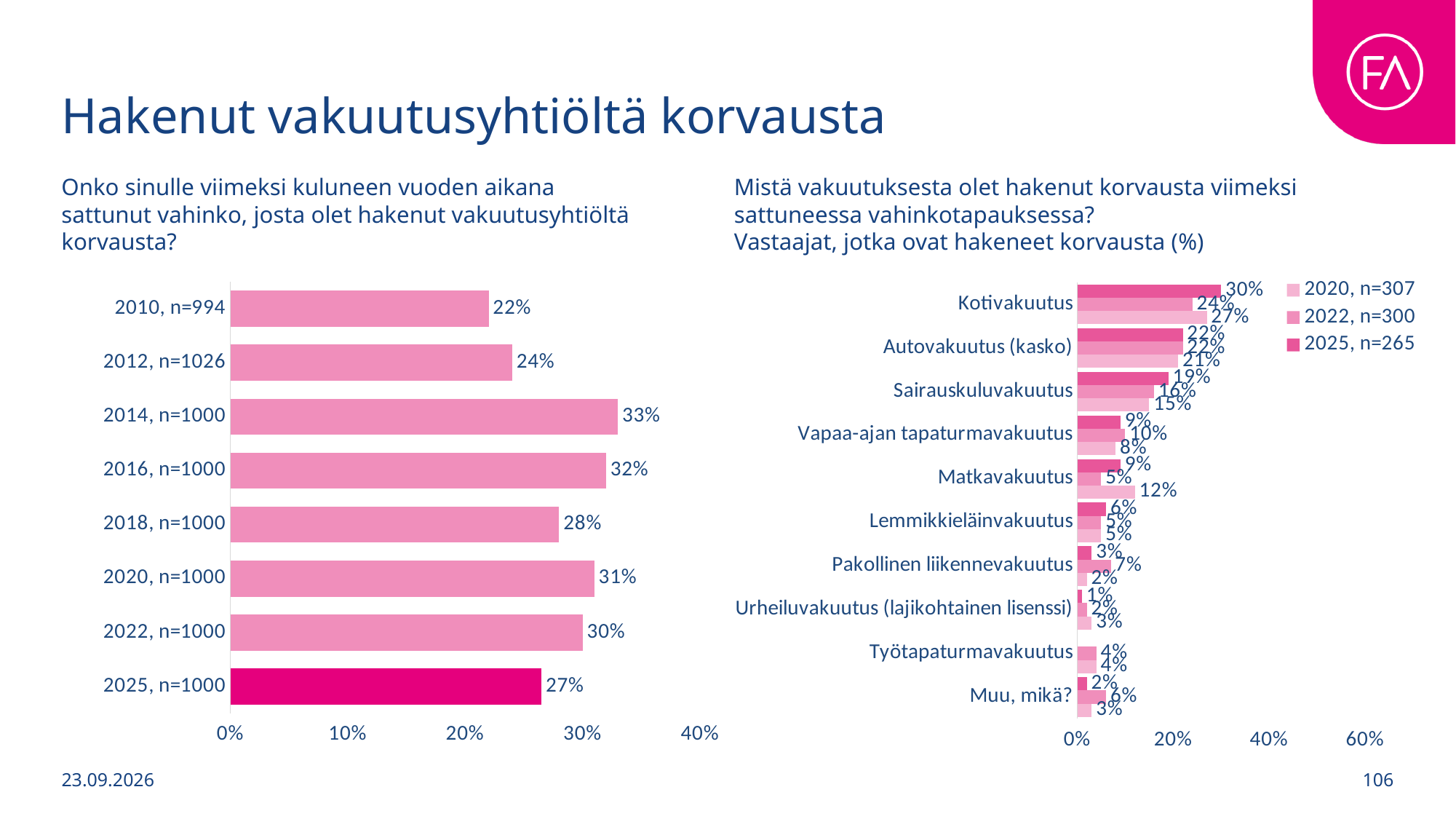
In the left chart, what percentage is shown for 2014, n=1000? 33% How many series does the legend of the right chart list? 3 In the left chart, what percentage is shown for 2025, n=1000? 27% In the left chart, which year has the lowest percentage? 2010, n=994 In the left chart, which is larger, the value for 2020 or the value for 2022? 2020 In the right chart, what is the 2020 value for Matkavakuutus? 12% In the right chart, which category has the highest values across all series? Kotivakuutus What type of chart is the left chart? Bar chart In the left chart, what is the difference between the values for 2014 and 2025? 6 percentage points How many bars are in the left chart? 8 In the right chart, what is the 2025 value for Kotivakuutus? 30% In the left chart, which year has the highest percentage? 2014, n=1000